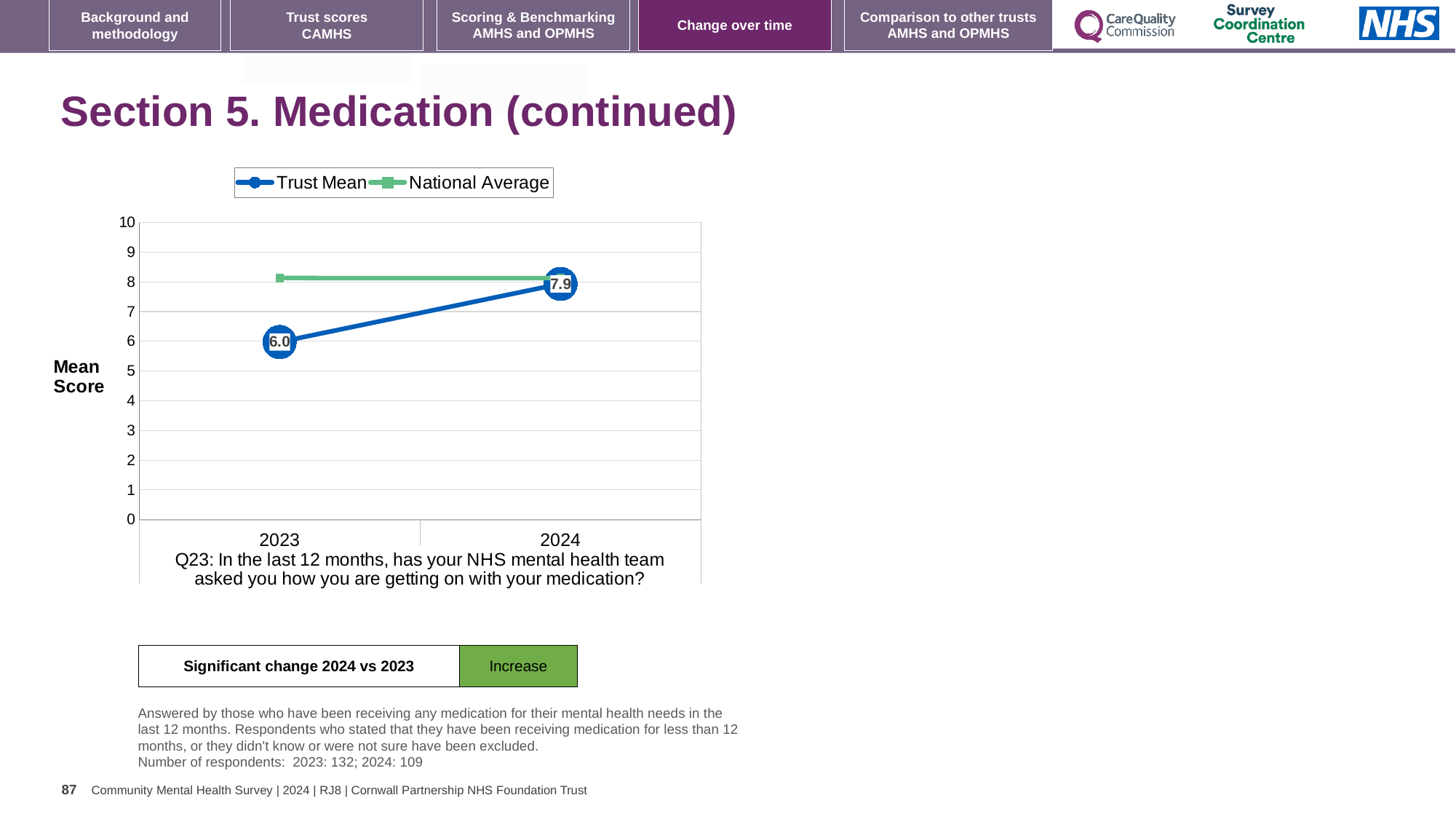
Is the National Average value for 2023 greater or less than 7? greater Which year has the higher Trust Mean, 2023 or 2024? 2024 What is the Trust Mean value for 2023? 6.0 By how much did the Trust Mean change from 2023 to 2024? 1.9 Is the Trust Mean value for 2023 greater or less than 7? less In 2023, which series has the higher value, Trust Mean or National Average? National Average What kind of chart is shown on the slide? line chart What is the label on the y axis of the chart? Mean Score Does the Trust Mean rise or fall from 2023 to 2024? rise How many years are shown on the x axis of the chart? 2 What is the Trust Mean value for 2024? 7.9 How many series does the chart legend list? 2